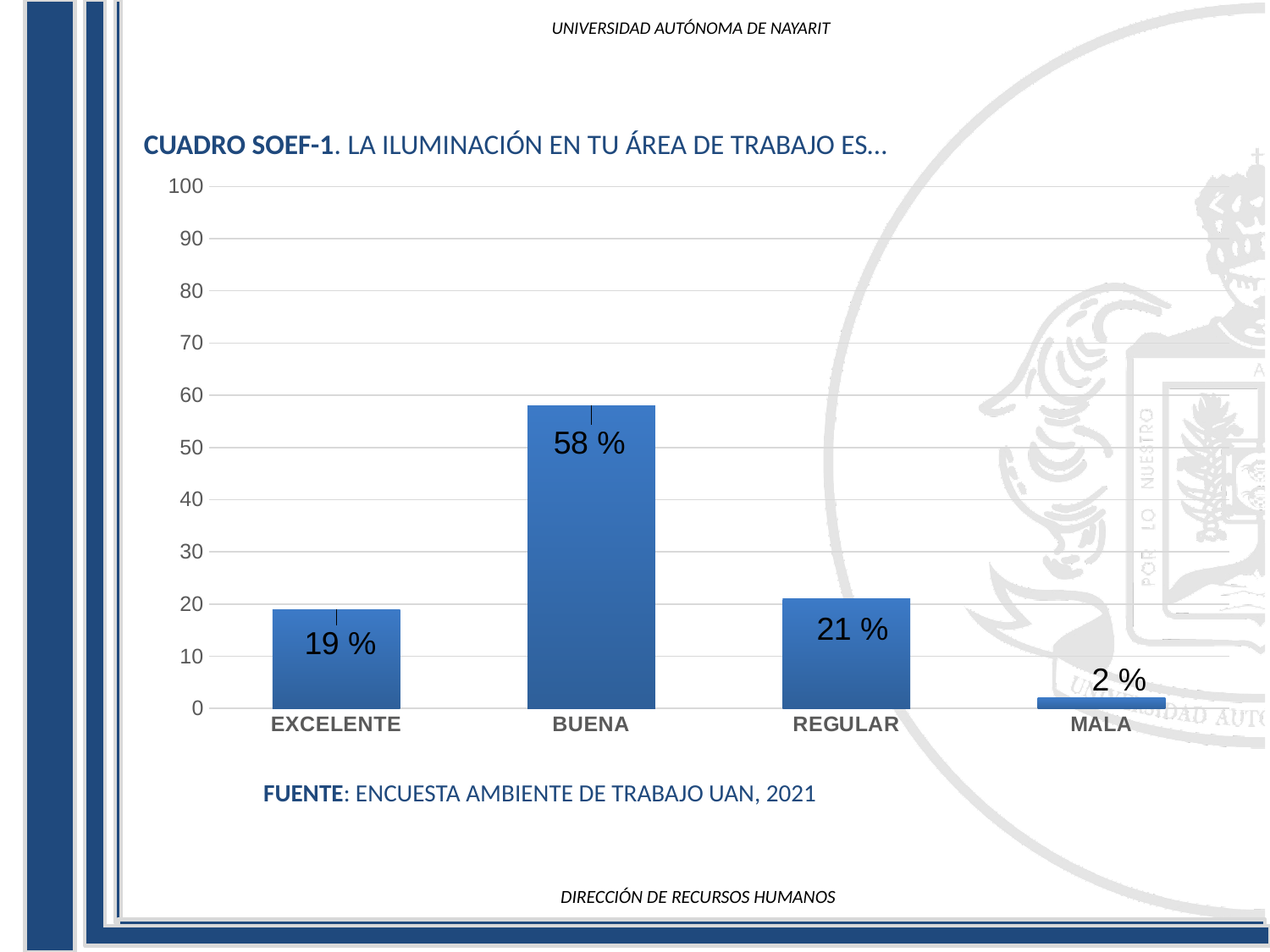
What is the difference between the values for REGULAR and EXCELENTE? 2 % What is the value for BUENA? 58 % How many categories are shown on the x axis? 4 What is the difference between the values for BUENA and REGULAR? 37 % Which category has the lowest value? MALA Which category has the highest value? BUENA What kind of chart is shown on the slide? bar chart Which is larger, the value for EXCELENTE or the value for MALA? EXCELENTE What is the value for EXCELENTE? 19 % What is the value for MALA? 2 % Is the value for BUENA greater or less than 50? greater What is the value for REGULAR? 21 %